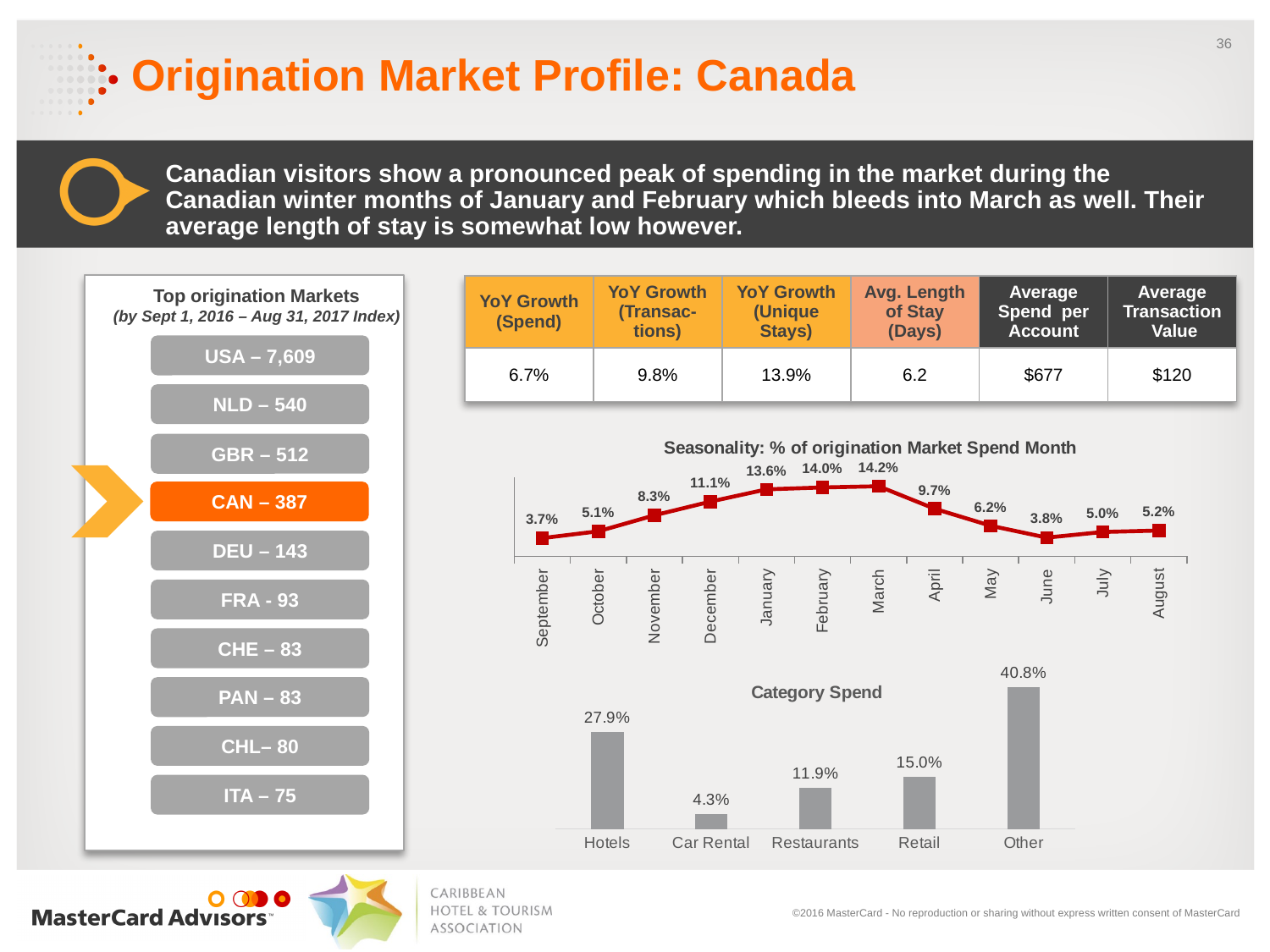
In the Category Spend chart, which is larger, Hotels or Retail? Hotels In the Category Spend chart, which category has the lowest value? Car Rental In the Seasonality chart, do the values rise or fall from September to March? rise In the Seasonality chart, what is the difference between the values for March and April? 4.5% What kind of chart is the Seasonality chart? line chart In the Seasonality chart, which month has the lowest value? September In the Category Spend chart, what is the value for Restaurants? 11.9% In the Seasonality chart, what is the value for January? 13.6% In the Seasonality chart, how many months are plotted? 12 In the Seasonality chart, which month has the highest value? March What kind of chart is the Category Spend chart? bar chart In the Category Spend chart, which category has the highest value? Other